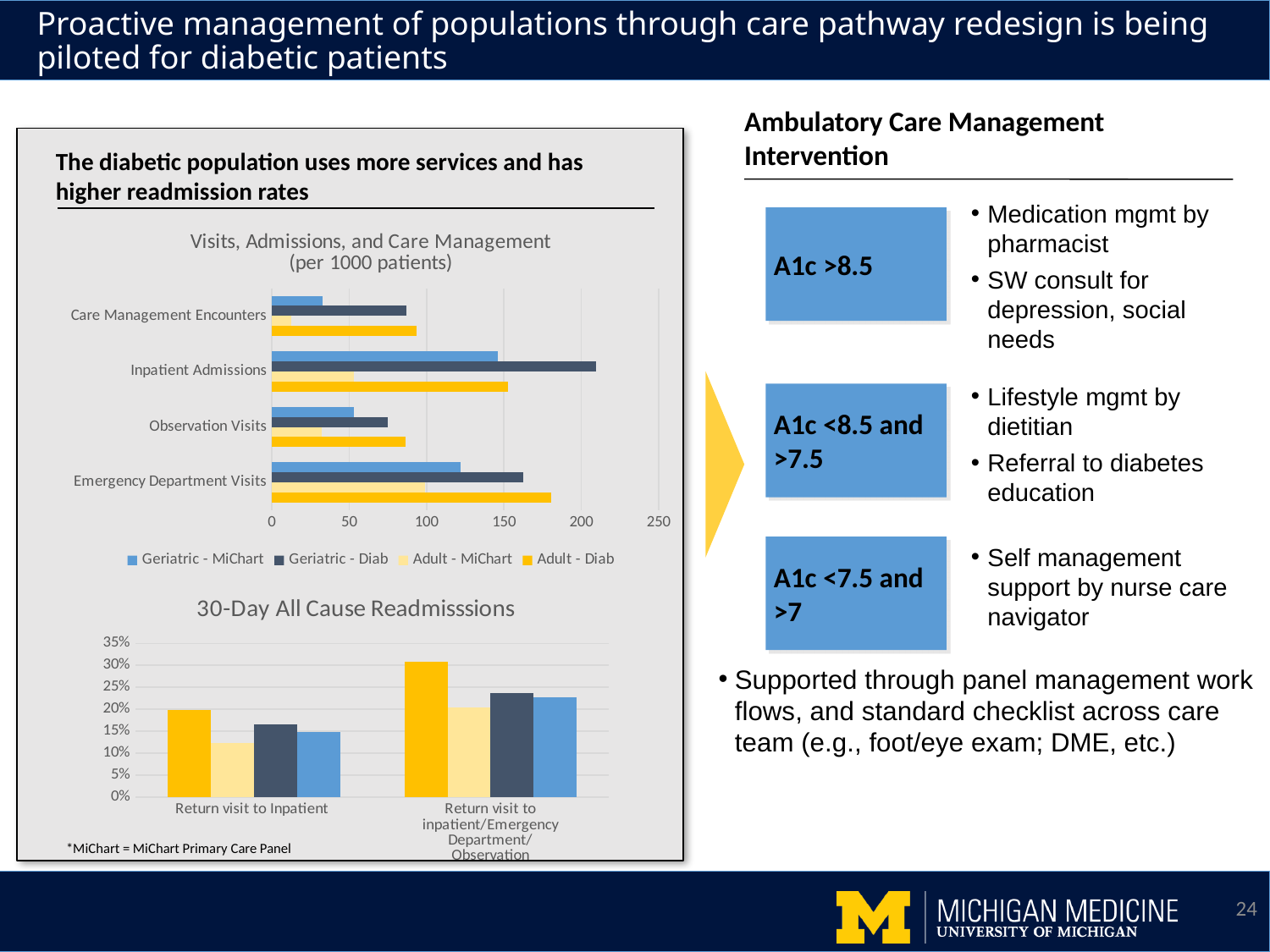
What kind of chart is the 'Visits, Admissions, and Care Management (per 1000 patients)' chart? bar chart In the 'Visits, Admissions, and Care Management (per 1000 patients)' chart, is the Geriatric - Diab value for Inpatient Admissions greater or less than 200? greater How many categories are shown on the '30-Day All Cause Readmisssions' chart? 2 How many series does the legend of the 'Visits, Admissions, and Care Management (per 1000 patients)' chart list? 4 How many categories are shown on the 'Visits, Admissions, and Care Management (per 1000 patients)' chart? 4 In the 'Visits, Admissions, and Care Management (per 1000 patients)' chart, is the Adult - Diab value for Emergency Department Visits greater or less than 150? greater In the '30-Day All Cause Readmisssions' chart, is the tallest bar for 'Return visit to inpatient/Emergency Department/Observation' greater or less than 25%? greater In the 'Visits, Admissions, and Care Management (per 1000 patients)' chart, for Inpatient Admissions, which is larger: Geriatric - Diab or Adult - Diab? Geriatric - Diab In the 'Visits, Admissions, and Care Management (per 1000 patients)' chart, which category has the lowest Adult - MiChart value? Care Management Encounters In the 'Visits, Admissions, and Care Management (per 1000 patients)' chart, which category has the highest Geriatric - Diab value? Inpatient Admissions